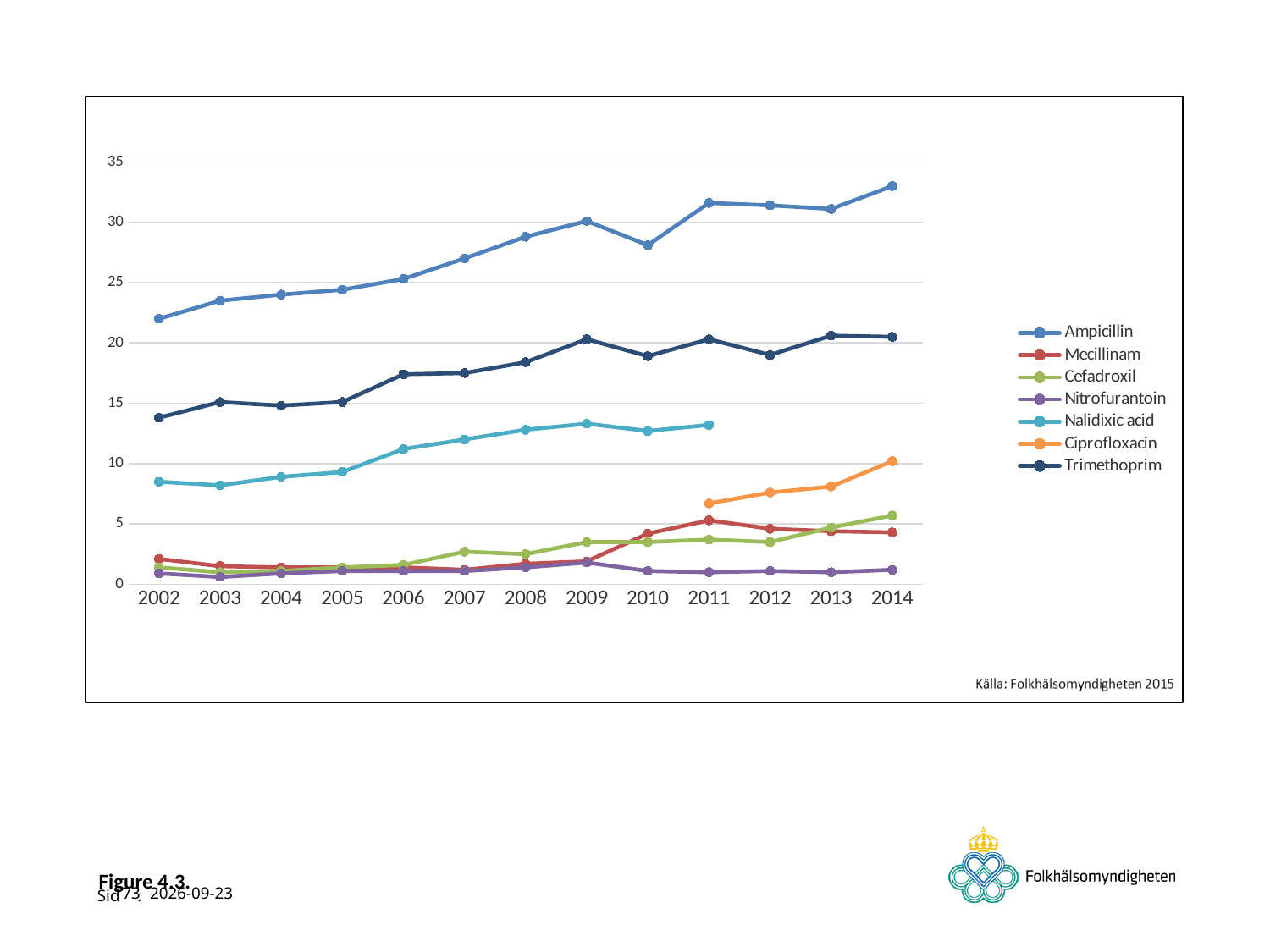
Is the value for Ampicillin in 2014 greater or less than 30? greater Which series has the lowest value in 2014? Nitrofurantoin Does the Ampicillin line generally rise or fall from 2002 to 2014? rise Which series has the highest value in 2014? Ampicillin Is the value for Ciprofloxacin in 2014 greater or less than 5? greater How many series does the legend list? 7 In 2009, which is larger: Trimethoprim or Nalidixic acid? Trimethoprim What kind of chart is shown on the slide? line chart Is the value for Nalidixic acid in 2002 greater or less than 10? less Which series first appears in 2011? Ciprofloxacin How many years are shown on the x axis? 13